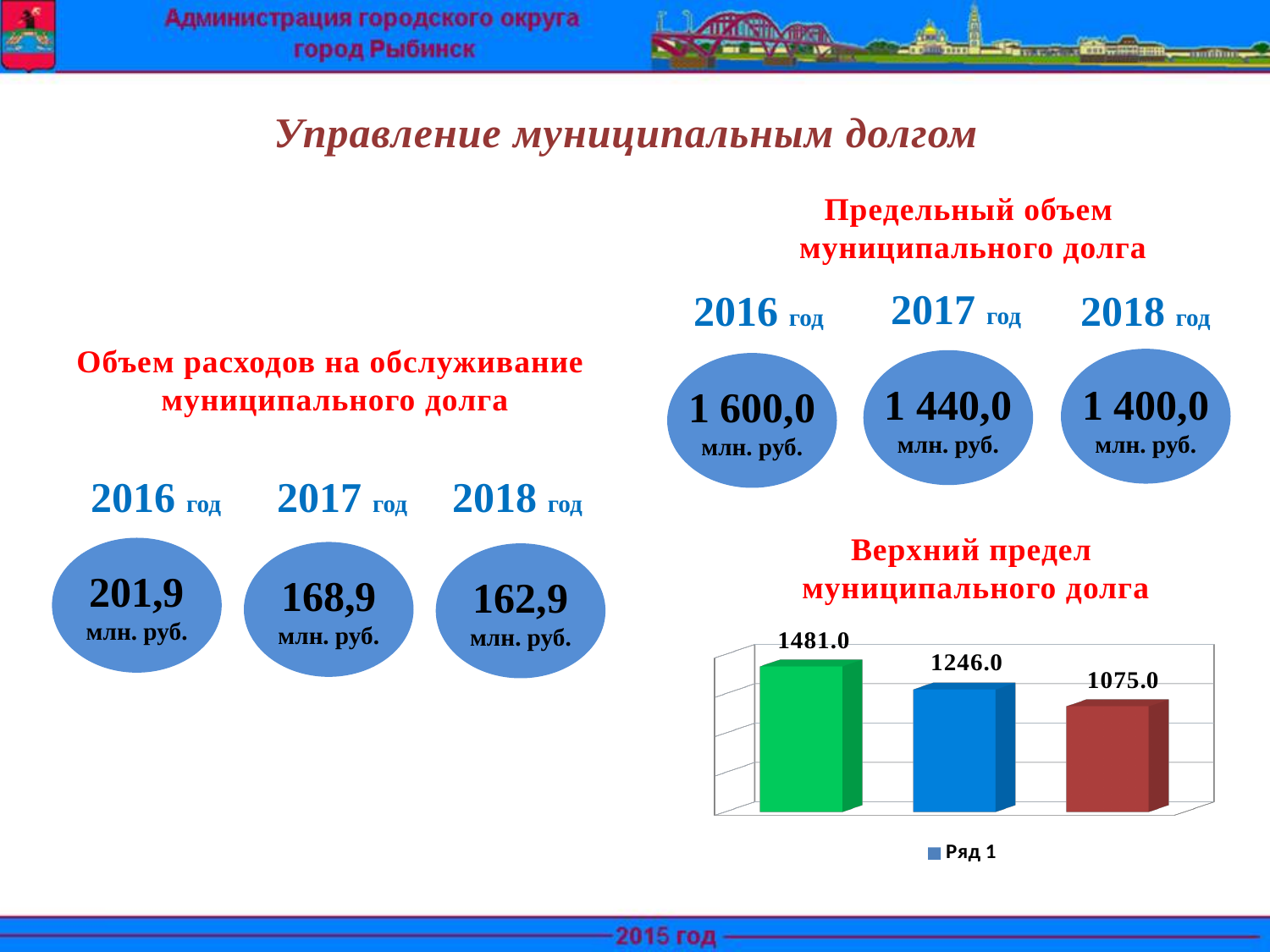
Which bar has the lowest value in the "Верхний предел муниципального долга" chart? the rightmost (red) bar, 1075.0 In the "Верхний предел муниципального долга" chart, which is larger: the middle bar or the rightmost bar? the middle bar (1246.0) Which bar has the highest value in the "Верхний предел муниципального долга" chart? the leftmost (green) bar, 1481.0 What is the value shown on the middle (blue) bar in the "Верхний предел муниципального долга" chart? 1246.0 How many series does the legend of the "Верхний предел муниципального долга" chart list? 1 What is the legend entry shown below the "Верхний предел муниципального долга" chart? Ряд 1 What kind of chart is shown under the heading "Верхний предел муниципального долга"? bar chart What is the value shown on the leftmost (green) bar in the "Верхний предел муниципального долга" chart? 1481.0 In the "Верхний предел муниципального долга" chart, what is the difference between the leftmost bar and the rightmost bar? 406.0 How many bars are plotted in the "Верхний предел муниципального долга" chart? 3 Do the values in the "Верхний предел муниципального долга" chart rise or fall from left to right? fall What is the value shown on the rightmost (red) bar in the "Верхний предел муниципального долга" chart? 1075.0